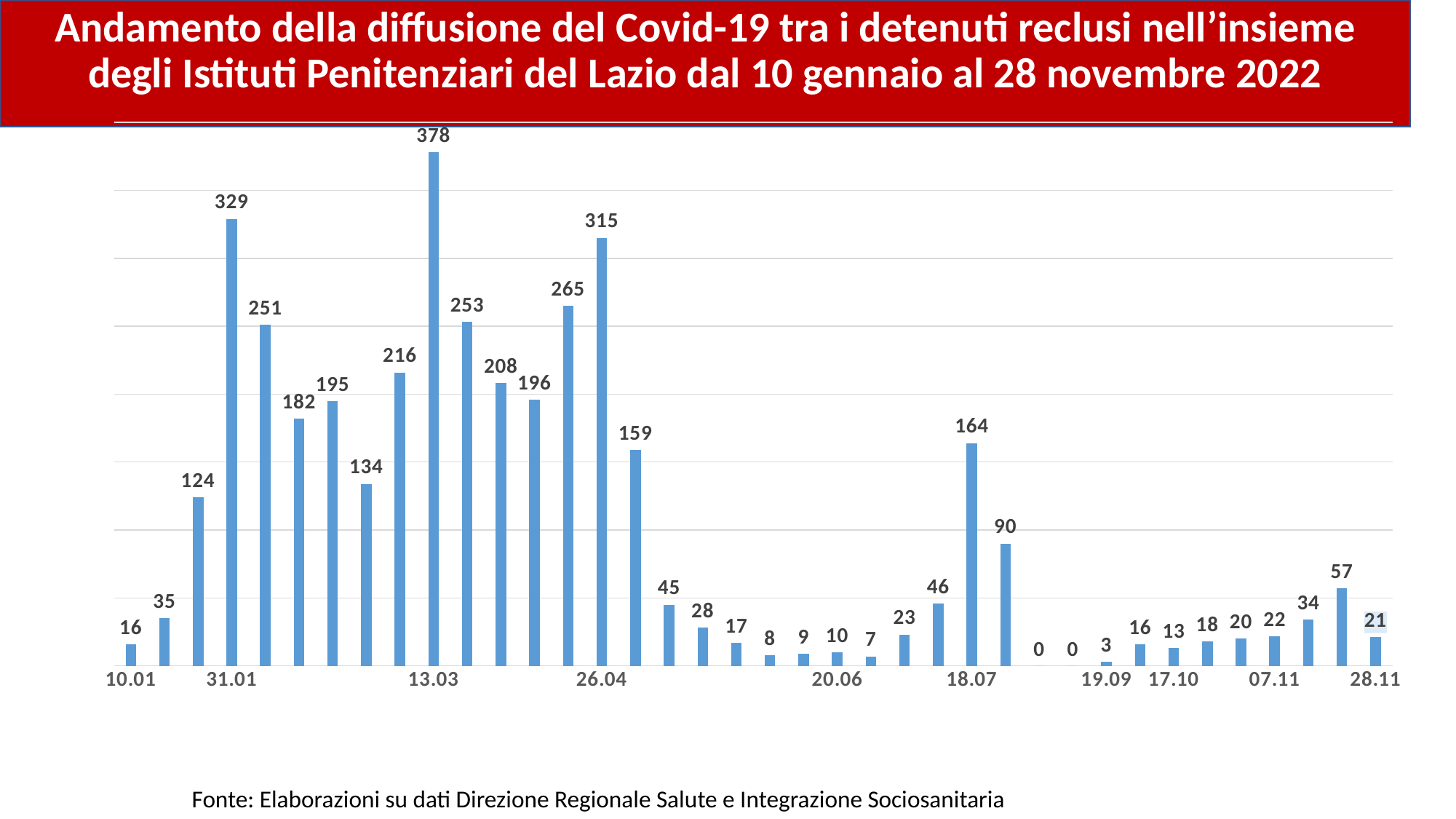
What is the value for 07.11? 22 What is the value for 13.03? 378 What kind of chart is shown on the slide? Bar chart What is the value for 31.01? 329 Which labelled date has the highest value? 13.03 What is the value for 28.11? 21 What is the difference between the values for 18.07 and 28.11? 143 How many bars are plotted in the chart? 38 What is the value for 19.09? 3 Which is larger, the value for 31.01 or the value for 26.04? 31.01 What is the difference between the values for 13.03 and 26.04? 63 What is the value for 18.07? 164